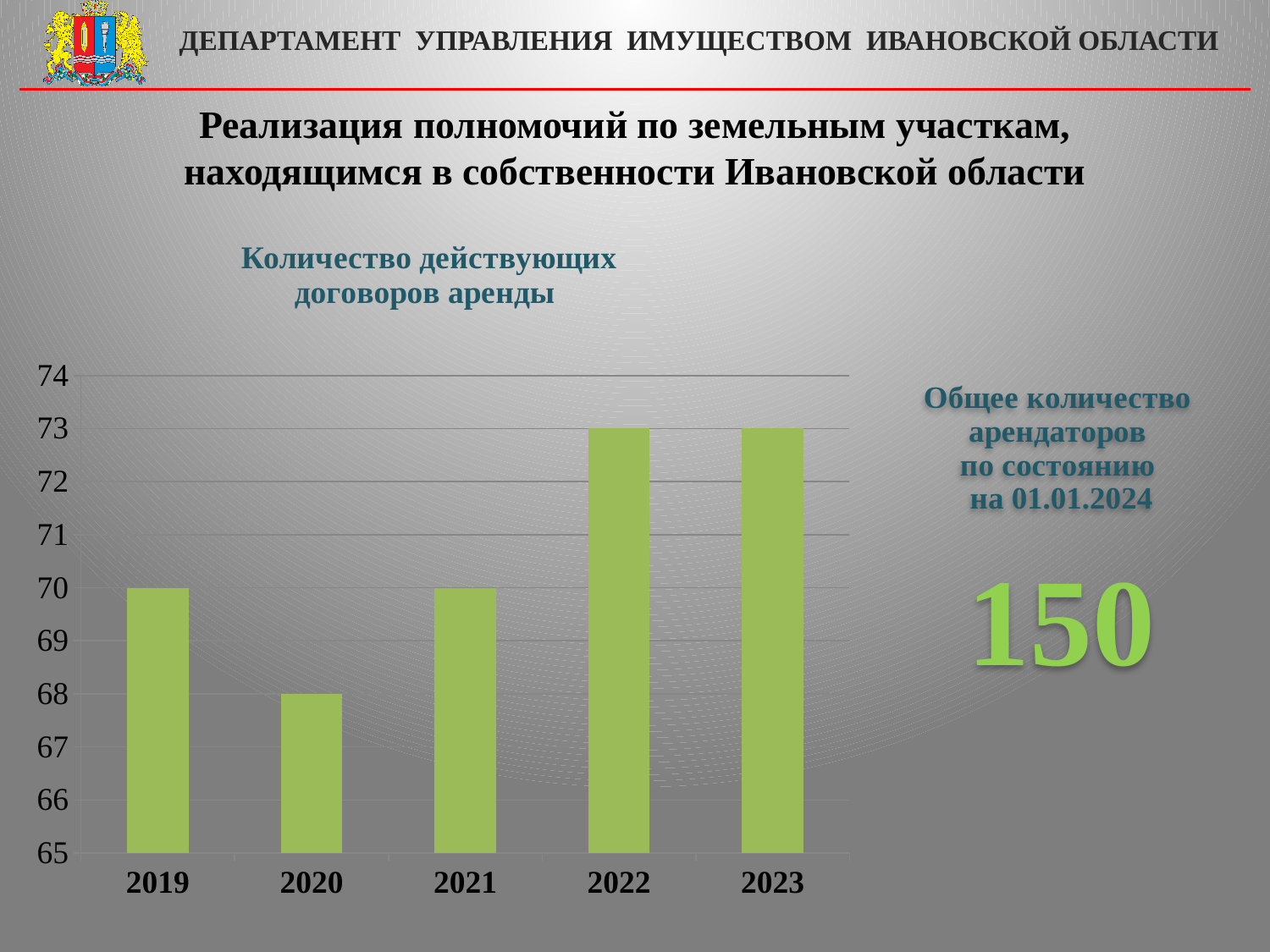
Is the value for 2020 greater or less than 70? less Is the value for 2023 greater or less than 70? greater Which is larger in the chart, the value for 2021 or the value for 2022? 2022 What is the value for 2022 in the chart? 73 What is the title of the chart? Количество действующих договоров аренды How many years are shown on the x axis of the chart? 5 What type of chart is shown on the slide? bar chart What is the difference between the values for 2022 and 2020 in the chart? 5 Which year has the lowest value in the chart? 2020 What is the value for 2020 in the chart? 68 What is the value for 2019 in the chart? 70 Do the values in the chart rise or fall from 2021 to 2022? rise